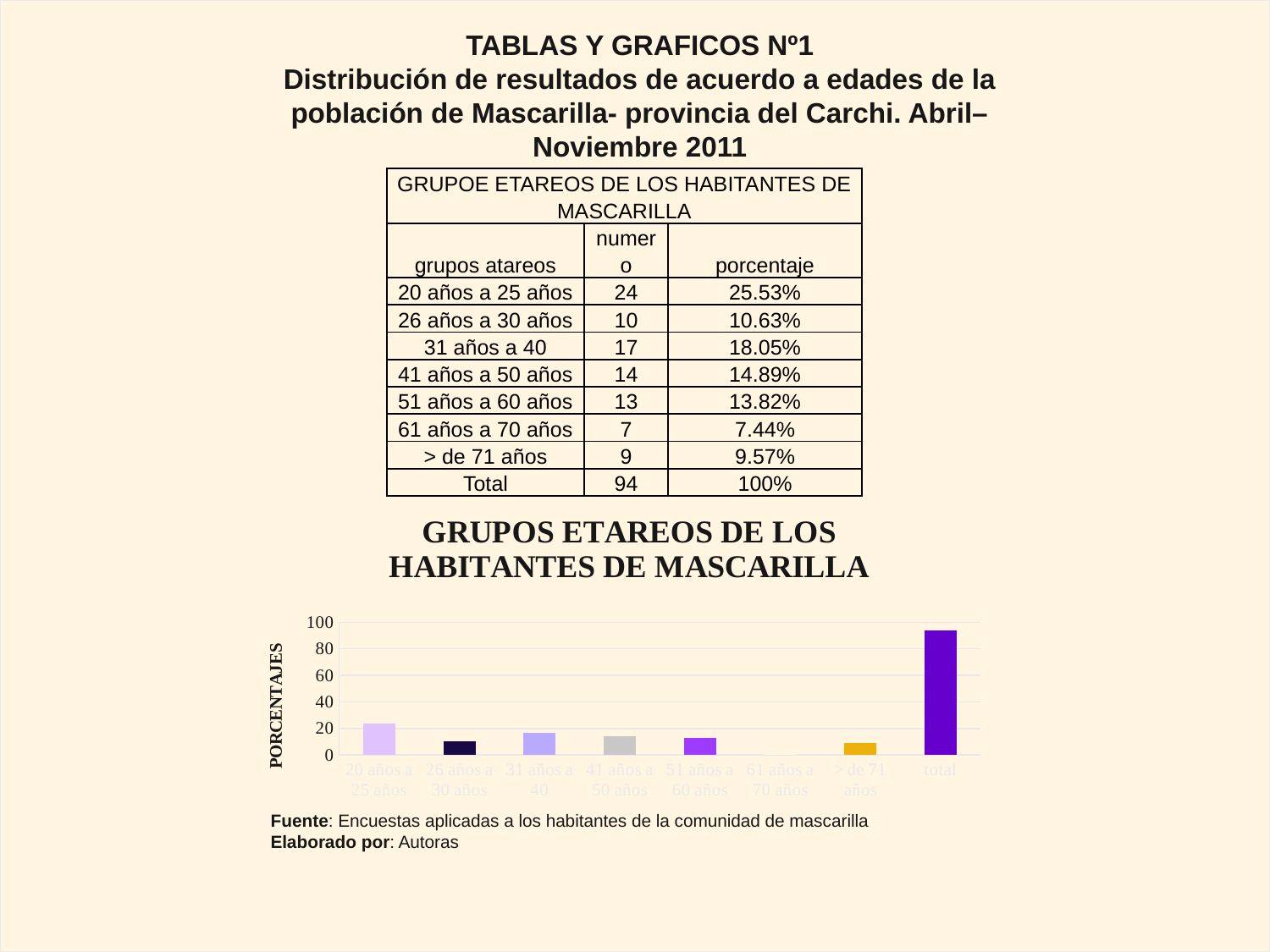
What is the title of the chart? GRUPOS ETAREOS DE LOS HABITANTES DE MASCARILLA What is the label on the vertical axis of the chart? PORCENTAJES Which bar is taller: 20 años a 25 años or 26 años a 30 años? 20 años a 25 años Which bar is taller: 31 años a 40 or 20 años a 25 años? 20 años a 25 años Is the value for 26 años a 30 años greater or less than 20? less Is the value for total greater or less than 80? greater Among the age-group bars (excluding total), which category has the tallest bar? 20 años a 25 años Is the value for 20 años a 25 años greater or less than 20? greater Which category has the tallest bar in the chart? total What kind of chart is shown on the slide? bar chart How many bars are plotted in the chart? 8